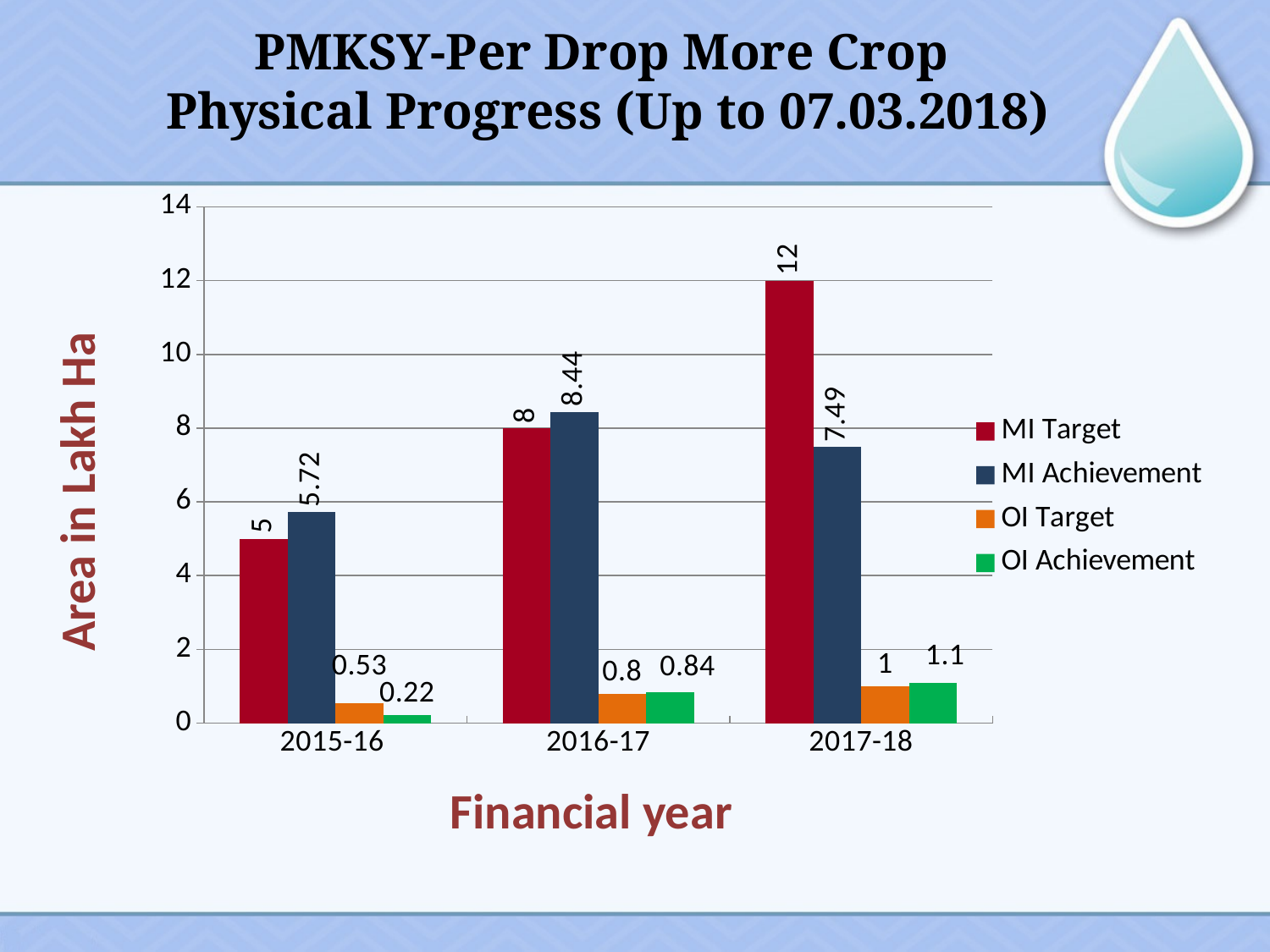
How many series does the legend list? 4 What is the label of the y axis? Area in Lakh Ha What is the difference between MI Target and MI Achievement in 2017-18? 4.51 Which financial year has the lowest OI Achievement? 2015-16 Which financial year has the highest MI Target? 2017-18 What is the MI Target value for 2017-18? 12 What is the OI Achievement value for 2015-16? 0.22 What is the MI Achievement value for 2016-17? 8.44 What is the OI Target value for 2017-18? 1 What kind of chart is shown on the slide? Bar chart How many financial years are shown on the x axis? 3 Which is larger in 2016-17, MI Target or MI Achievement? MI Achievement